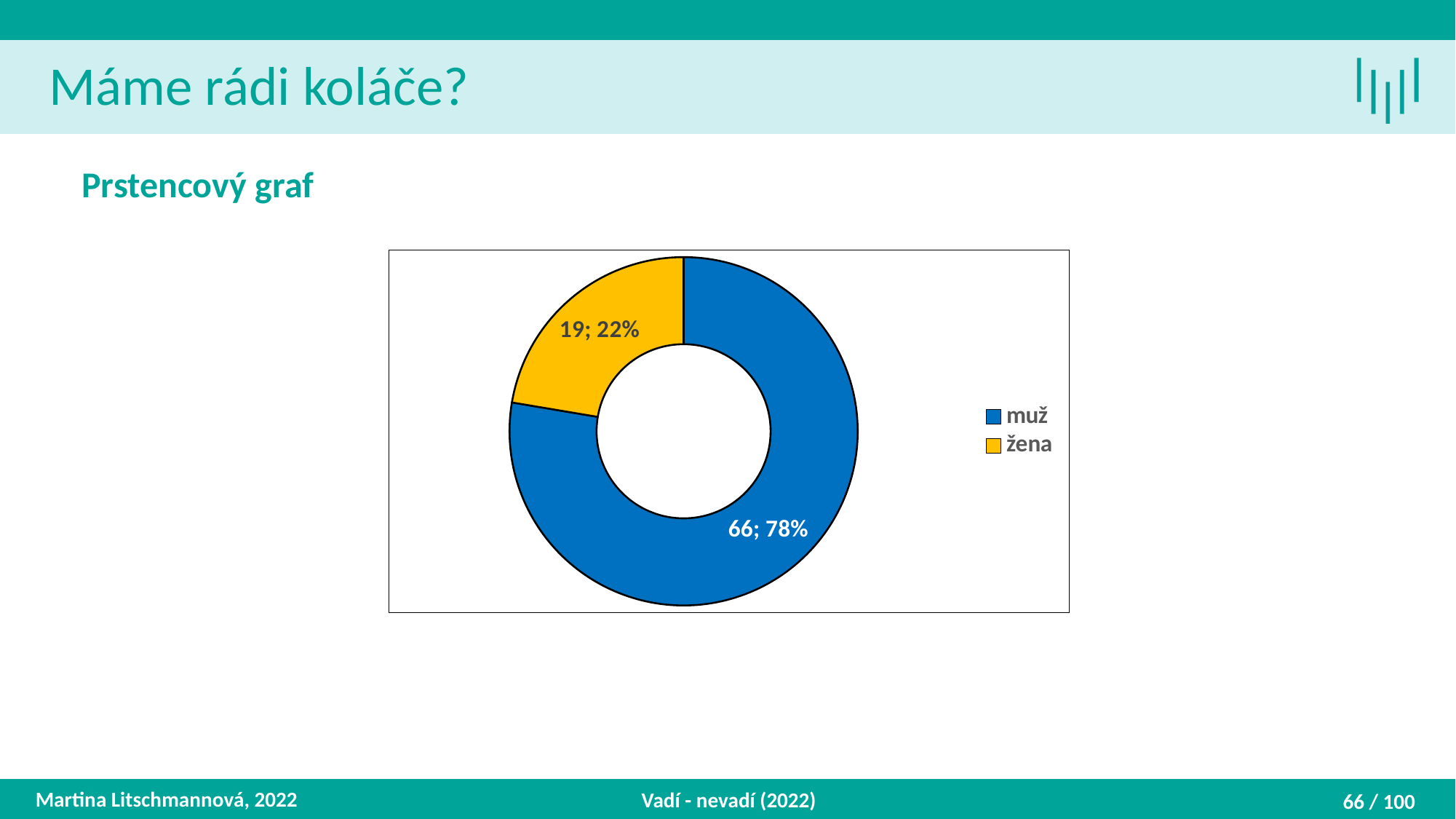
What is the total of the counts shown in the chart? 85 What kind of chart is shown on the slide? Doughnut chart Which is larger, the count for muž or for žena? muž What is the difference between the counts for muž and žena? 47 What share of the doughnut does muž represent? 78% Which category has the largest share? muž How many categories does the chart show? 2 What is the count for muž? 66 What is the count for žena? 19 Which category has the smallest share? žena What colour represents žena in the chart? Yellow What share of the doughnut does žena represent? 22%